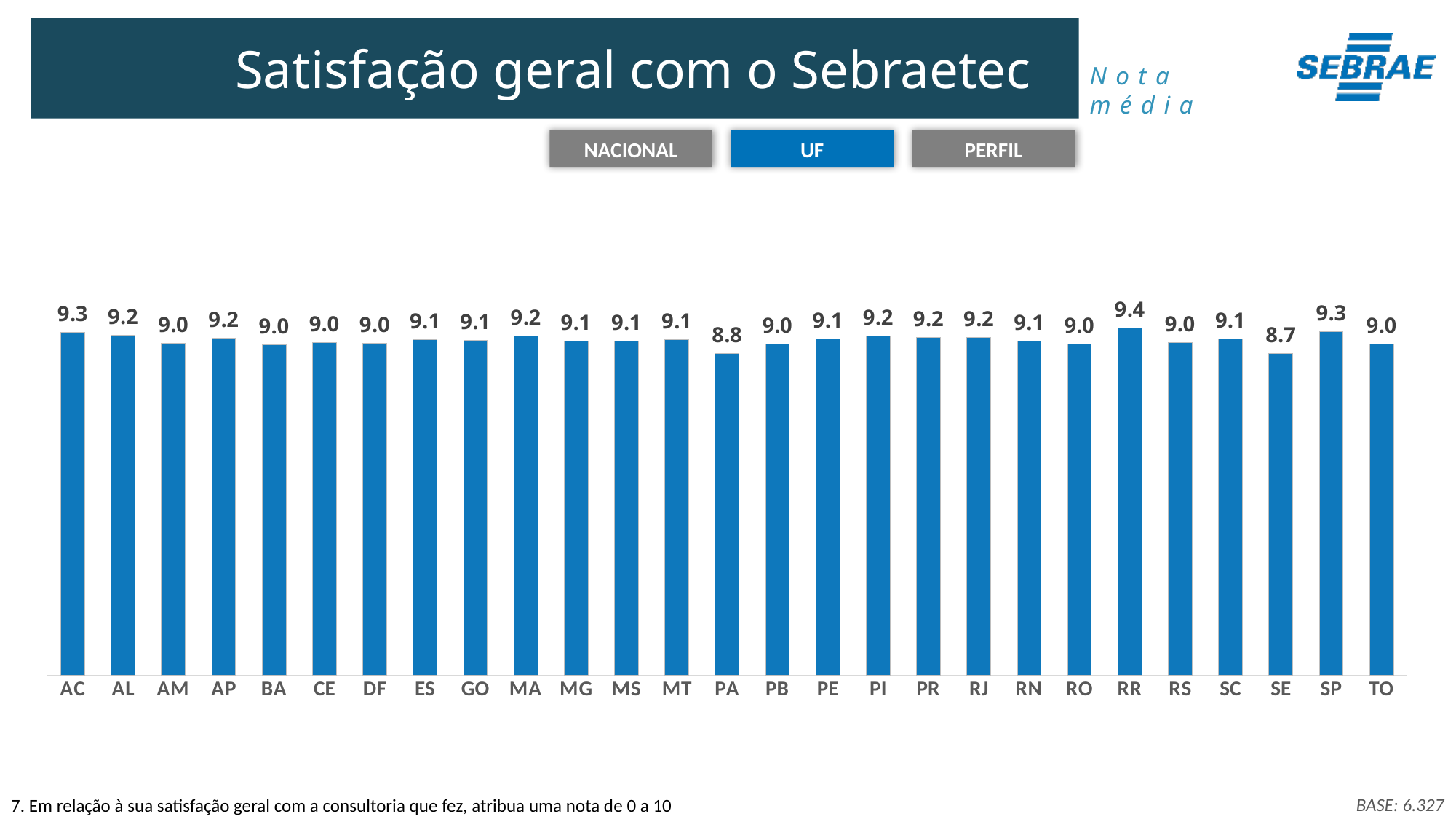
What is the difference between the scores for SP and PA? 0.5 Which UF has the highest average score? RR What kind of chart is shown on the slide? Bar chart What is the difference between the scores for RR and SE? 0.7 Which UF has the lowest average score? SE What is the value shown for SP? 9.3 What is the average score shown for PA? 8.8 Which has a higher score, AC or PA? AC What is the value shown for SE? 8.7 How many UFs (categories) are shown in the chart? 27 What is the average score (nota média) for RR? 9.4 What is the title of the slide containing the chart? Satisfação geral com o Sebraetec